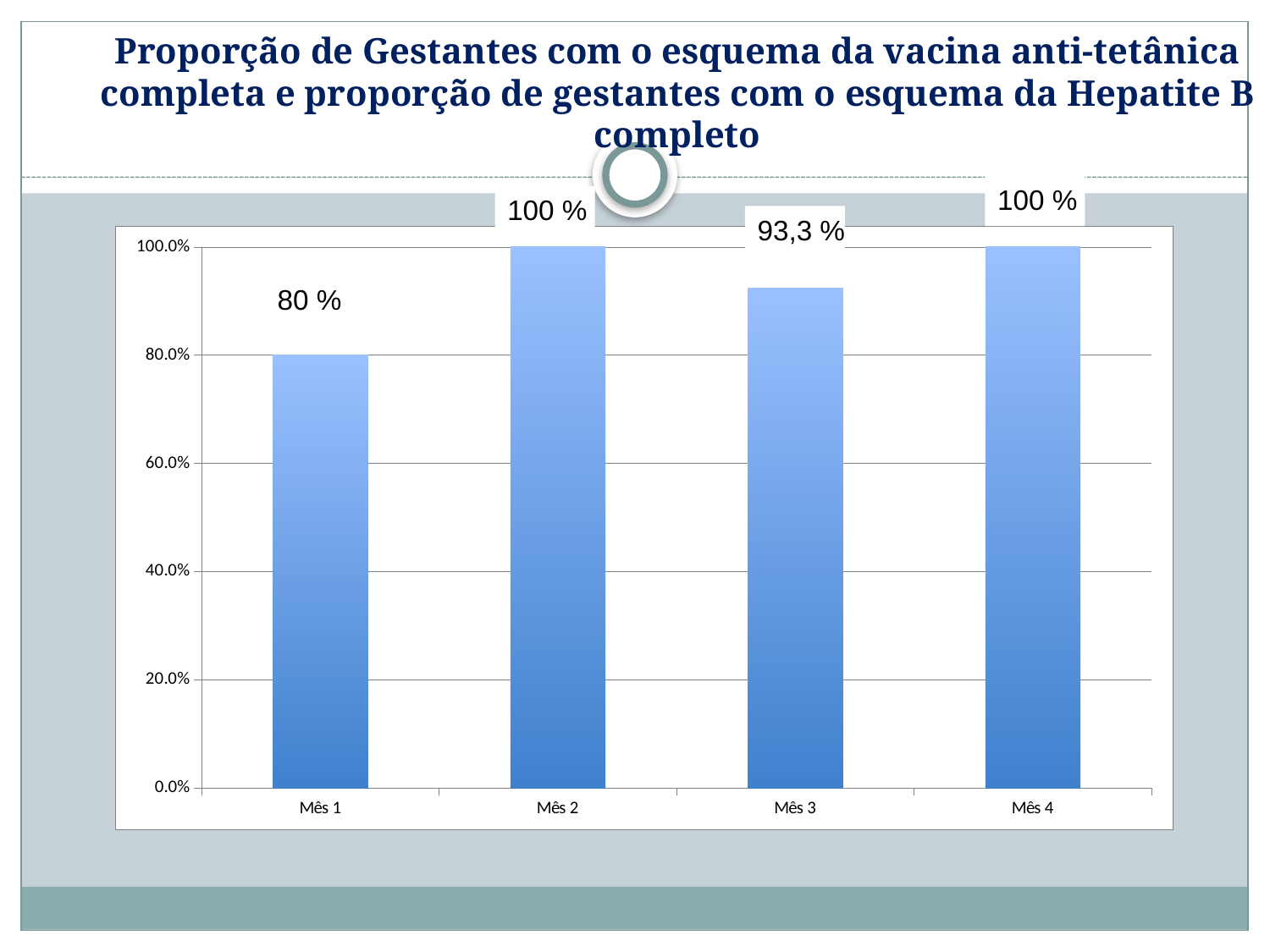
What is the difference between the values for Mês 3 and Mês 1? 13,3 % What is the value for Mês 4? 100 % What kind of chart is shown on the slide? bar chart What is the value for Mês 2? 100 % What is the value for Mês 3? 93,3 % Which months share the highest value? Mês 2 and Mês 4 What is the value for Mês 1? 80 % Which is larger, the value for Mês 3 or the value for Mês 1? Mês 3 Which month has the lowest value? Mês 1 Is the value for Mês 3 greater or less than 80.0%? greater How many months are shown on the x axis? 4 What is the difference between the values for Mês 2 and Mês 1? 20 %